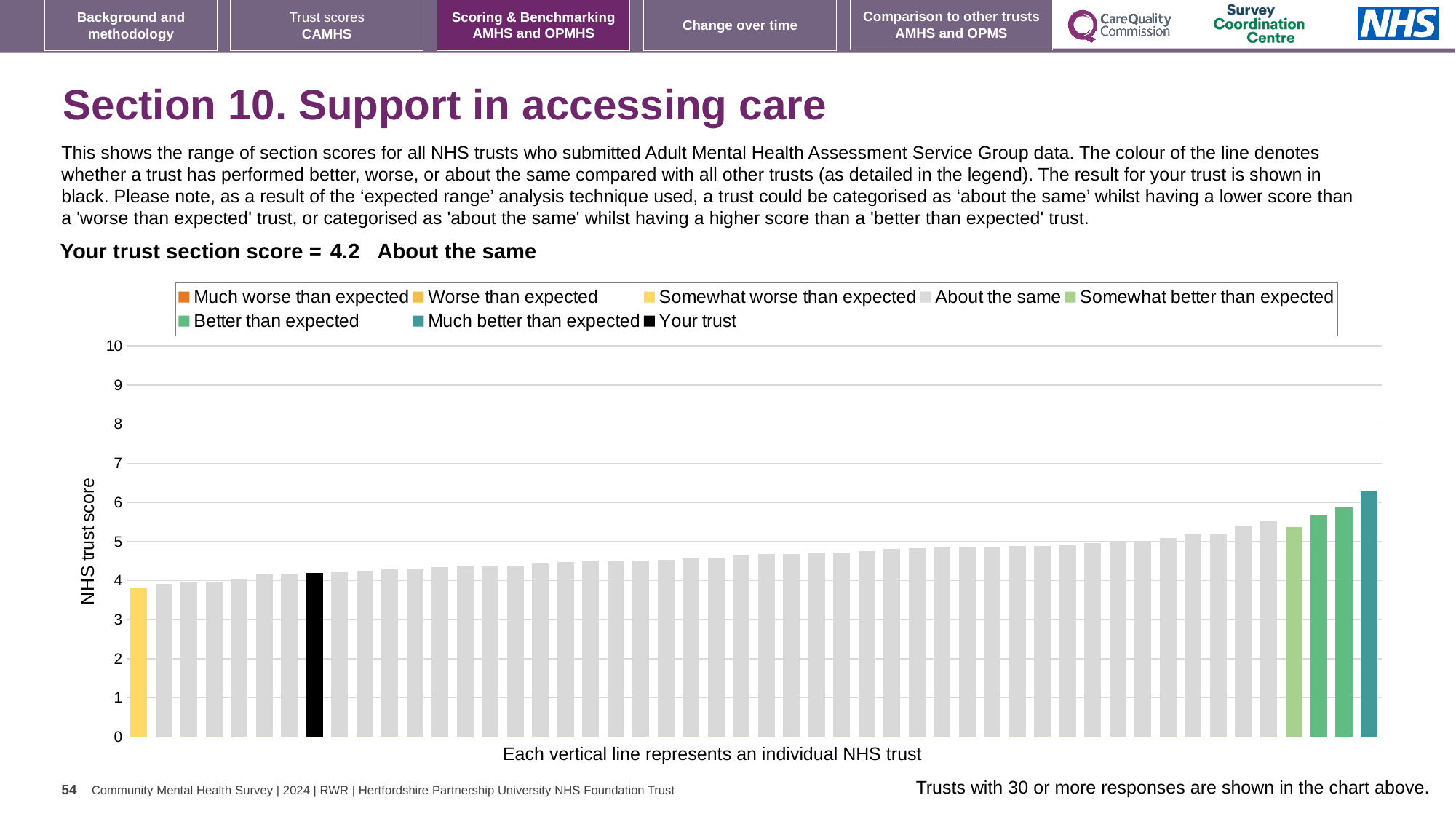
Do the bar values rise or fall from left to right along the x axis? rise Is the value of the shortest bar greater or less than 4? less What is the section score for your trust? 4.2 Is the value for your trust greater or less than 5? less Is the value of the tallest bar greater or less than 6? greater How is your trust's section score categorised compared with other trusts? About the same What is the label on the vertical axis? NHS trust score How many entries does the chart legend list? 8 Which legend category does the tallest bar belong to? Much better than expected What kind of chart is shown on the slide? bar chart